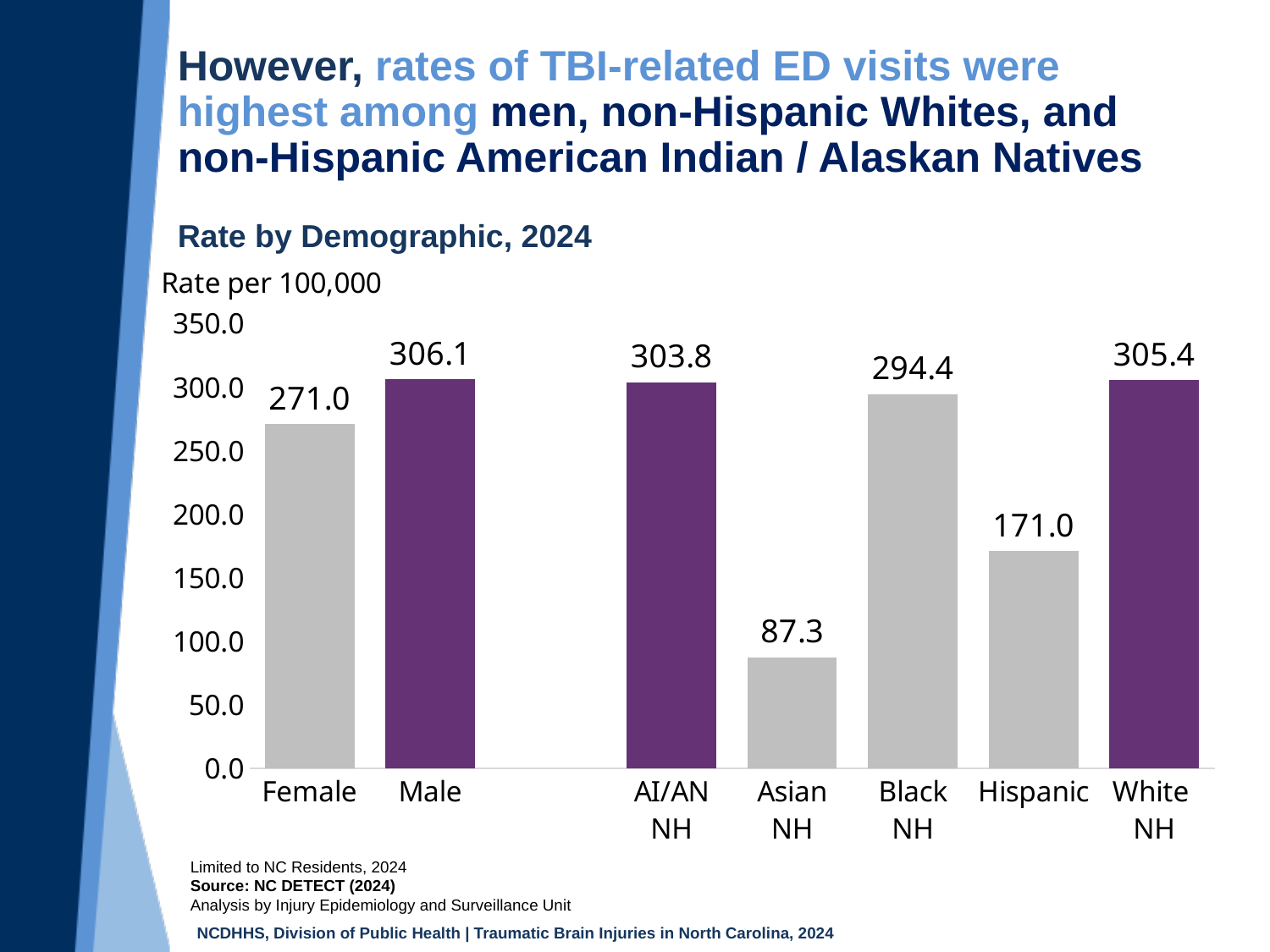
Which category has the lowest rate? Asian NH What is the rate per 100,000 for Black NH? 294.4 What is the rate per 100,000 for Asian NH? 87.3 Which category has the highest rate? Male Is the value for Hispanic greater or less than 200.0? less Which is larger, the rate for Female or the rate for Male? Male What is the rate per 100,000 for Female? 271.0 What is the title of the chart? Rate by Demographic, 2024 How many categories are shown in the chart? 7 What is the rate per 100,000 for Hispanic? 171.0 What kind of chart is shown on the slide? bar chart What is the difference between the Male and Female rates? 35.1